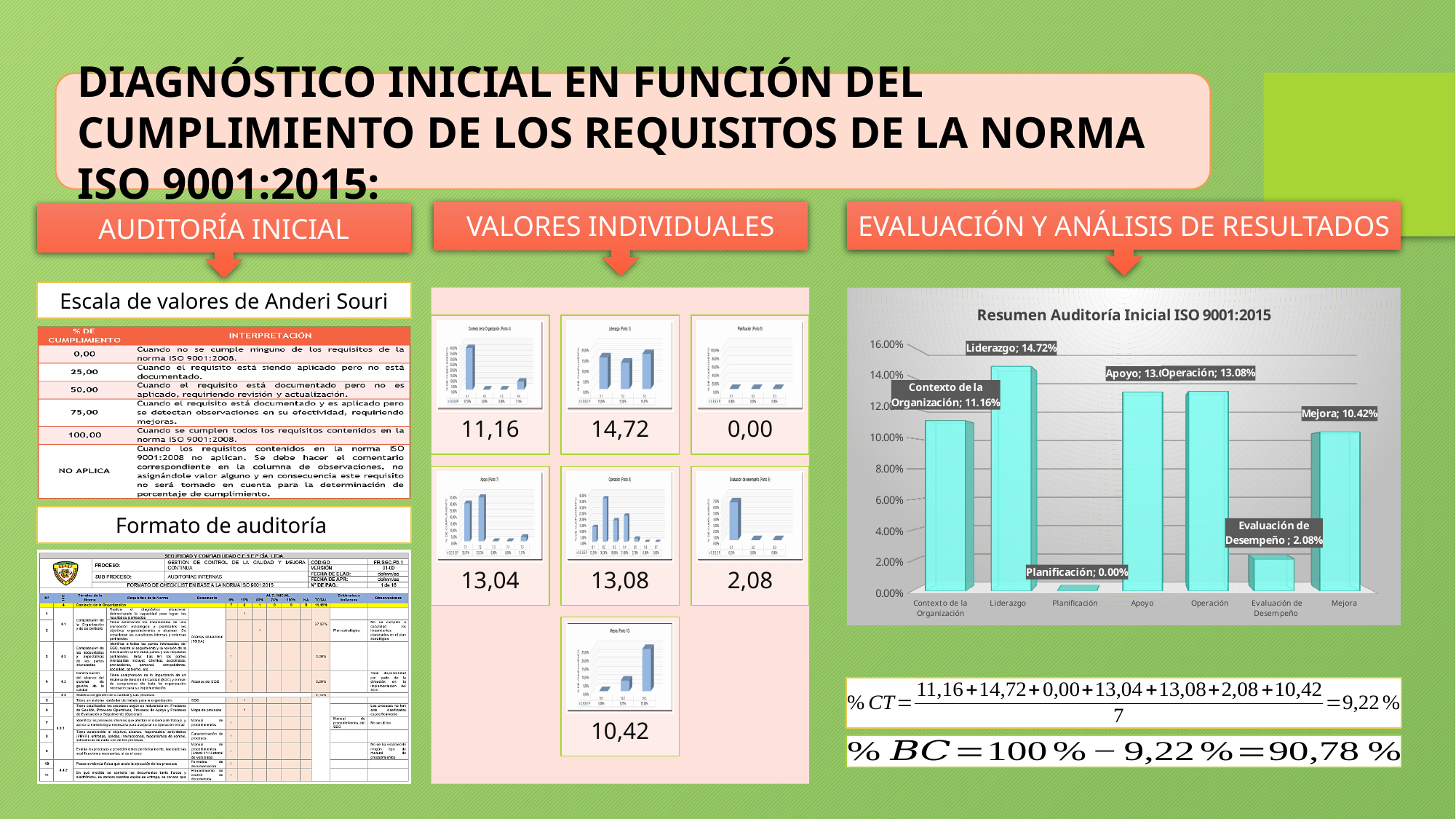
In the chart 'Resumen Auditoría Inicial ISO 9001:2015', what is the value for Contexto de la Organización? 11.16% In the chart 'Resumen Auditoría Inicial ISO 9001:2015', what is the value for Liderazgo? 14.72% What kind of chart is 'Resumen Auditoría Inicial ISO 9001:2015'? Bar chart In the chart 'Resumen Auditoría Inicial ISO 9001:2015', what is the value for Evaluación de Desempeño? 2.08% In the chart 'Resumen Auditoría Inicial ISO 9001:2015', which category has the lowest value? Planificación In the chart 'Resumen Auditoría Inicial ISO 9001:2015', which is larger, the value for Operación or the value for Contexto de la Organización? Operación In the chart 'Resumen Auditoría Inicial ISO 9001:2015', what is the value for Planificación? 0.00% In the chart 'Resumen Auditoría Inicial ISO 9001:2015', what is the value for Mejora? 10.42% In the chart 'Resumen Auditoría Inicial ISO 9001:2015', is the value for Apoyo greater or less than 12.00%? greater In the chart 'Resumen Auditoría Inicial ISO 9001:2015', which category has the highest value? Liderazgo In the chart 'Resumen Auditoría Inicial ISO 9001:2015', what is the difference between the values for Liderazgo and Mejora? 4.30% How many categories are shown on the x axis of the chart 'Resumen Auditoría Inicial ISO 9001:2015'? 7